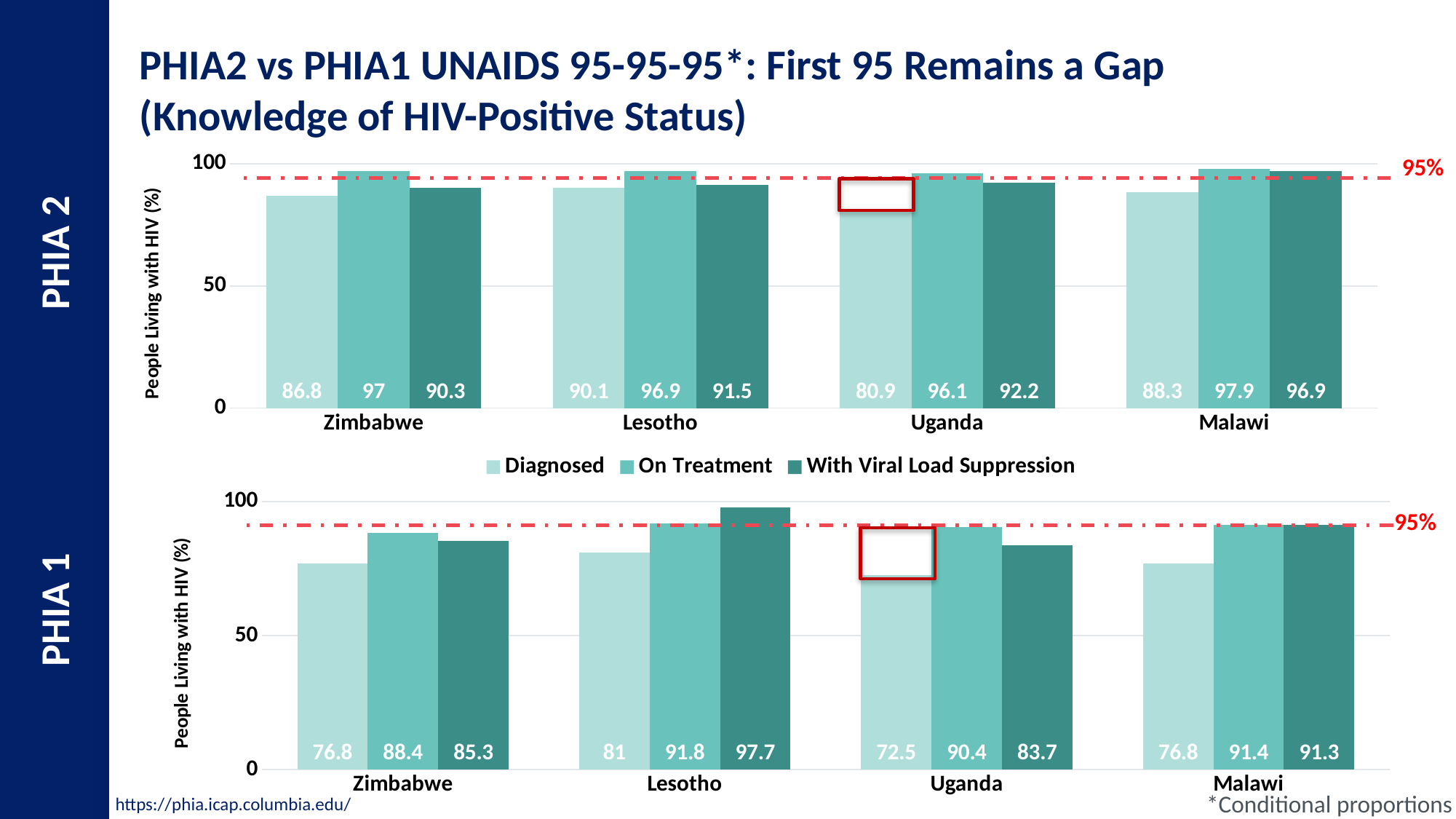
In the PHIA 1 chart (bottom), which country has the highest With Viral Load Suppression value? Lesotho In the PHIA 2 chart (top), what is the Diagnosed value for Uganda? 80.9 In the PHIA 2 chart (top), which country has the lowest Diagnosed value? Uganda In the PHIA 2 chart (top), is the Diagnosed value for Zimbabwe greater or less than 50? greater What value does the red dashed horizontal line on each chart mark? 95% In the PHIA 1 chart (bottom), what is the With Viral Load Suppression value for Lesotho? 97.7 How many series does the legend list for the charts? 3 In the PHIA 2 chart (top), what is the On Treatment value for Malawi? 97.9 How many countries are shown on the x axis of the PHIA 1 chart (bottom)? 4 What kind of chart is the PHIA 2 chart (top)? bar chart In the PHIA 1 chart (bottom), which is larger for Zimbabwe: the On Treatment value or the With Viral Load Suppression value? On Treatment What is the difference between the Diagnosed value for Uganda in the PHIA 2 chart (top) and in the PHIA 1 chart (bottom)? 8.4